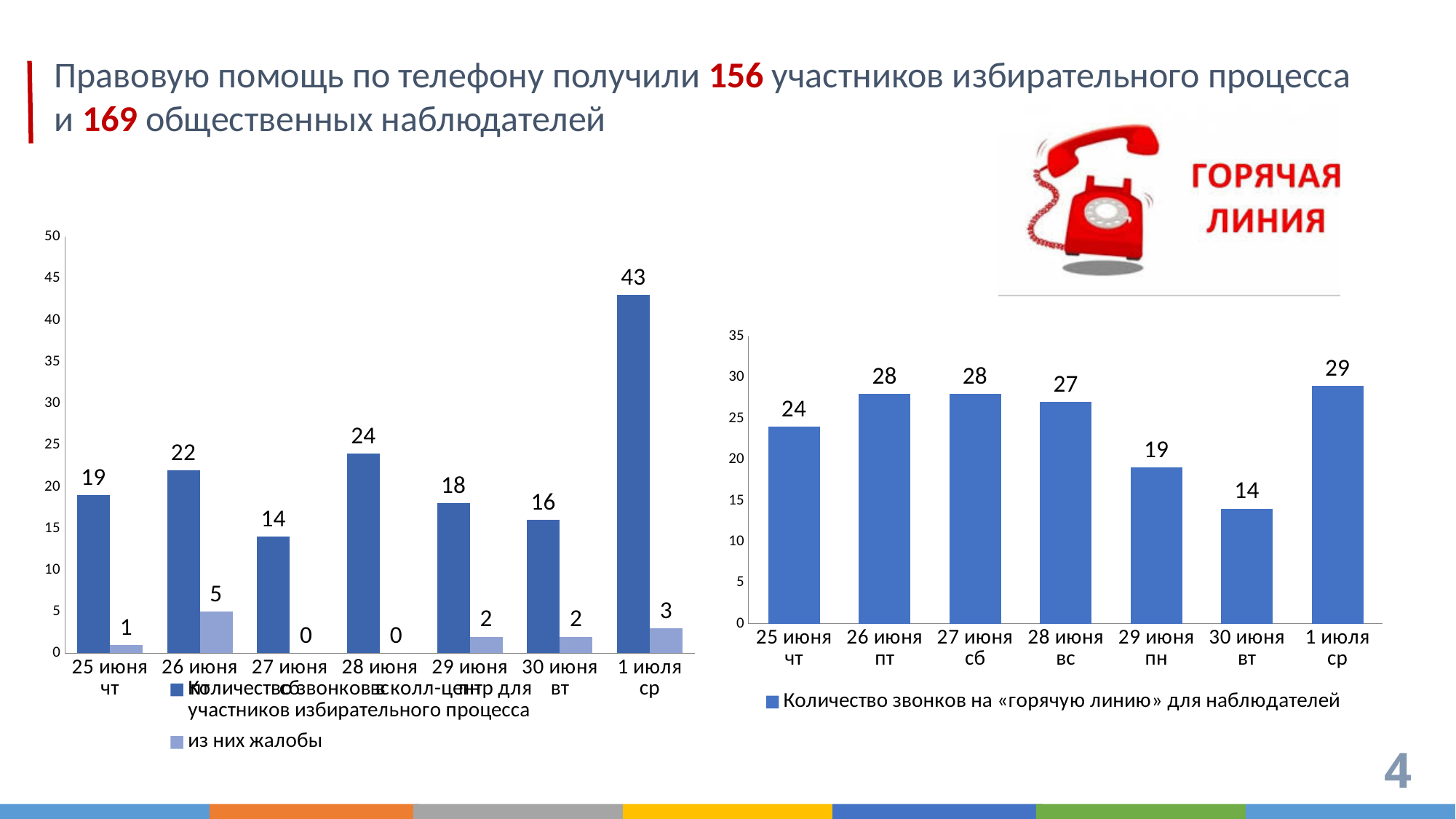
In the left chart, how many series does the legend list? 2 In the right chart, on which date was the number of hotline calls for observers lowest? 30 июня In the left chart, on which date was the number of calls to the call centre for election participants highest? 1 июля In the left chart, how many calls to the call centre for election participants were there on 1 июля? 43 In the left chart, on which date was the number of calls to the call centre for election participants lowest? 27 июня In the left chart, how many complaints (из них жалобы) were there on 26 июня? 5 In the right chart, which is larger: the hotline calls on 25 июня or on 29 июня? 25 июня In the left chart, what is the difference between the calls for election participants on 1 июля and on 28 июня? 19 In the right chart, how many calls to the hotline for observers were there on 30 июня? 14 What type of chart is the right chart? Bar chart In the right chart, how many dates are shown on the x axis? 7 In the right chart, on which date was the number of hotline calls for observers highest? 1 июля